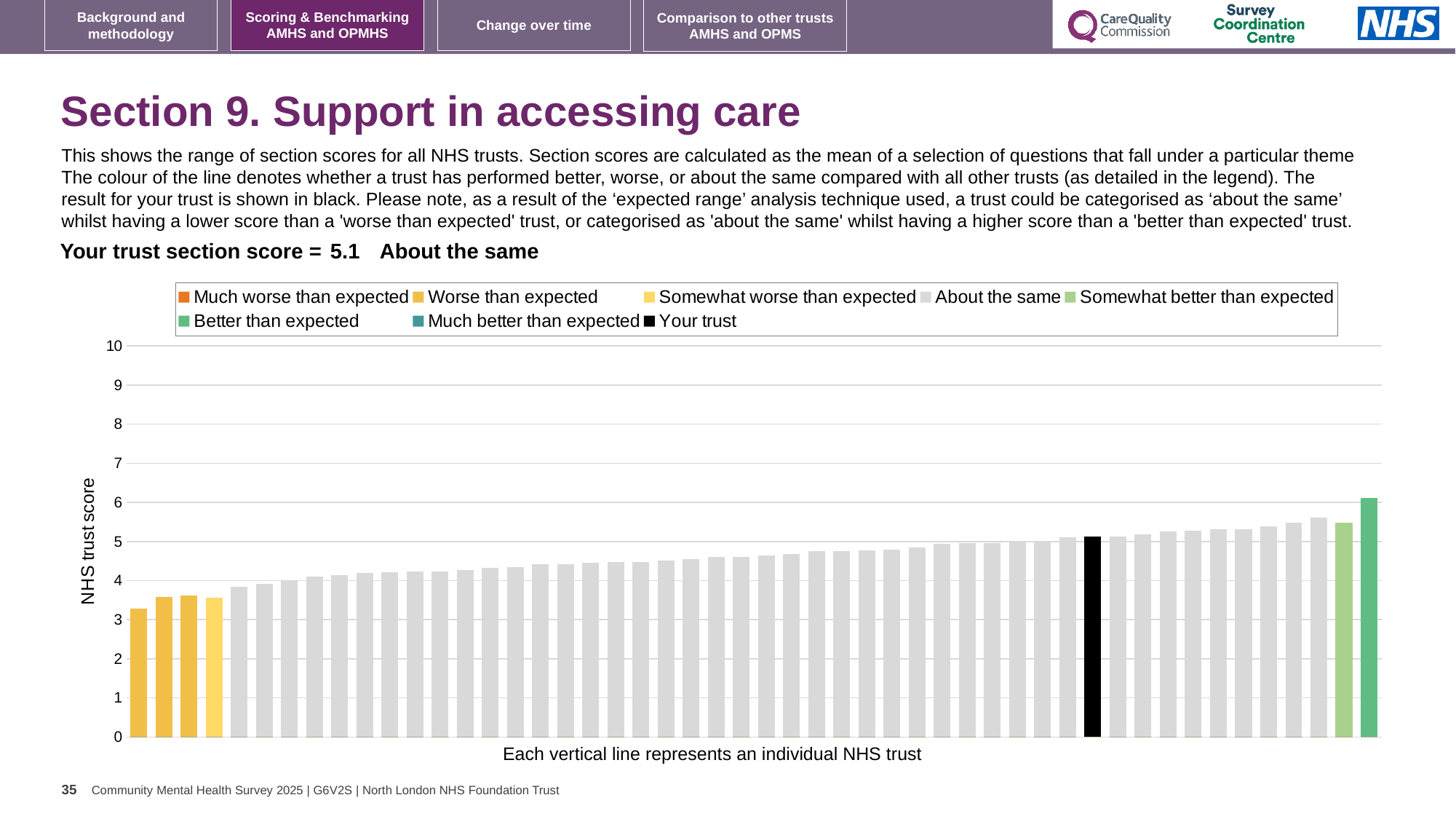
Do the bar values rise or fall from left to right along the x axis? rise What is the label on the vertical axis? NHS trust score Which category is your trust placed in for this section? About the same What is the highest value shown on the vertical axis? 10 How many entries does the chart legend list? 8 Is the value of the highest bar greater or less than 7? less Is the value of the lowest bar greater or less than 4? less Is the value for your trust greater or less than 5? greater Which legend category does the highest bar belong to? Better than expected What kind of chart is shown on the slide? bar chart What is the section score for your trust? 5.1 How many bars are coloured black to represent your trust? 1